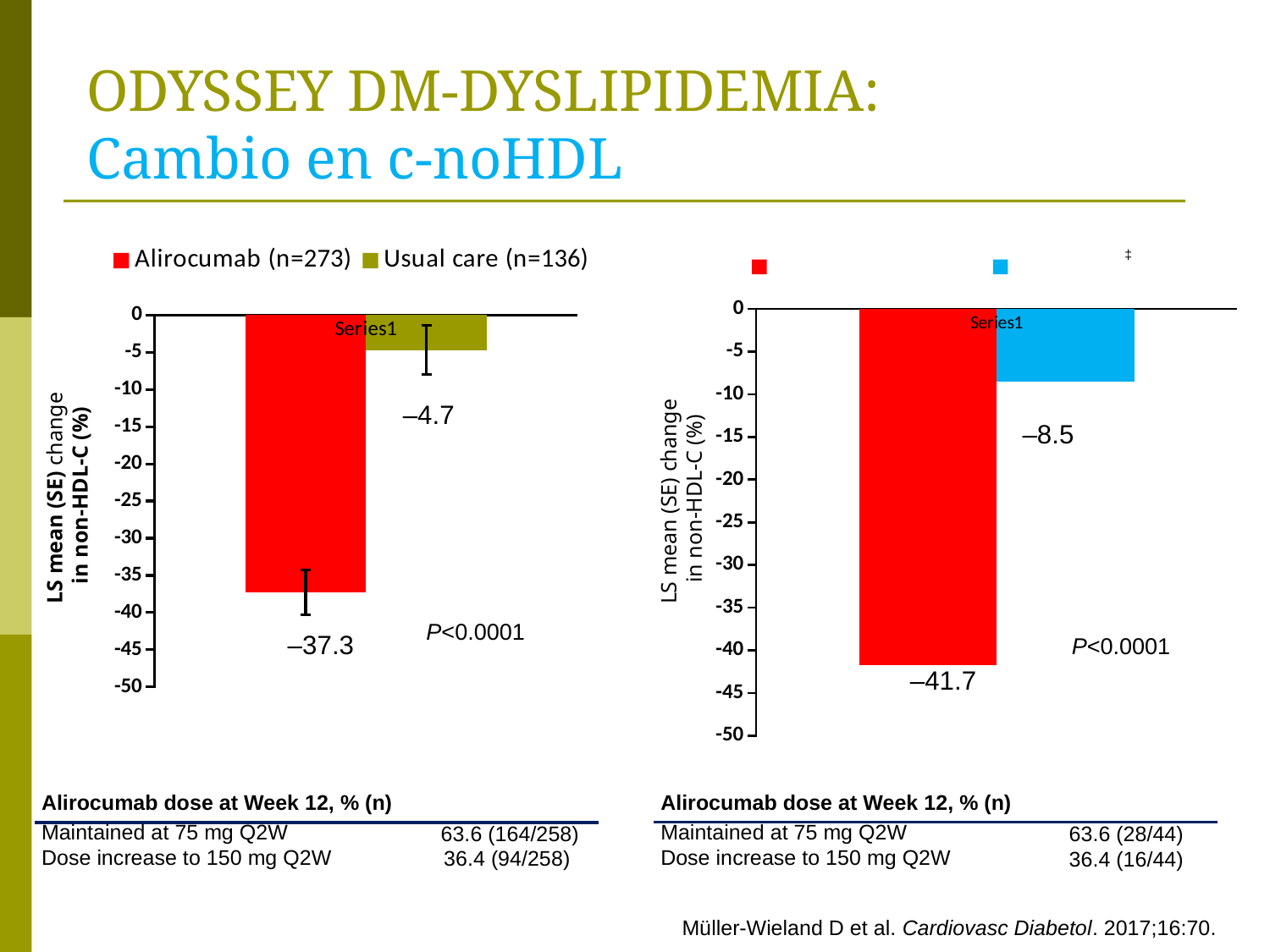
On the left chart, what is the LS mean change in non-HDL-C for Alirocumab (n=273)? –37.3 On the left chart, is the value for Alirocumab (n=273) greater or less than -35? less On the right chart, what value is labelled on the blue bar? –8.5 On the left chart, what is the LS mean change in non-HDL-C for Usual care (n=136)? –4.7 On the right chart, is the value for the blue bar greater or less than -10? greater On the right chart, what is the difference between the red bar value and the blue bar value? 33.2 On the left chart, which group shows the larger reduction in non-HDL-C, Alirocumab or Usual care? Alirocumab How many series does the legend of the left chart list? 2 What P value is shown on the left chart? P<0.0001 On the left chart, what is the difference between the Alirocumab value and the Usual care value? 32.6 On the right chart, what value is labelled on the red bar? –41.7 What type of chart is shown on the left side of the slide? Bar chart